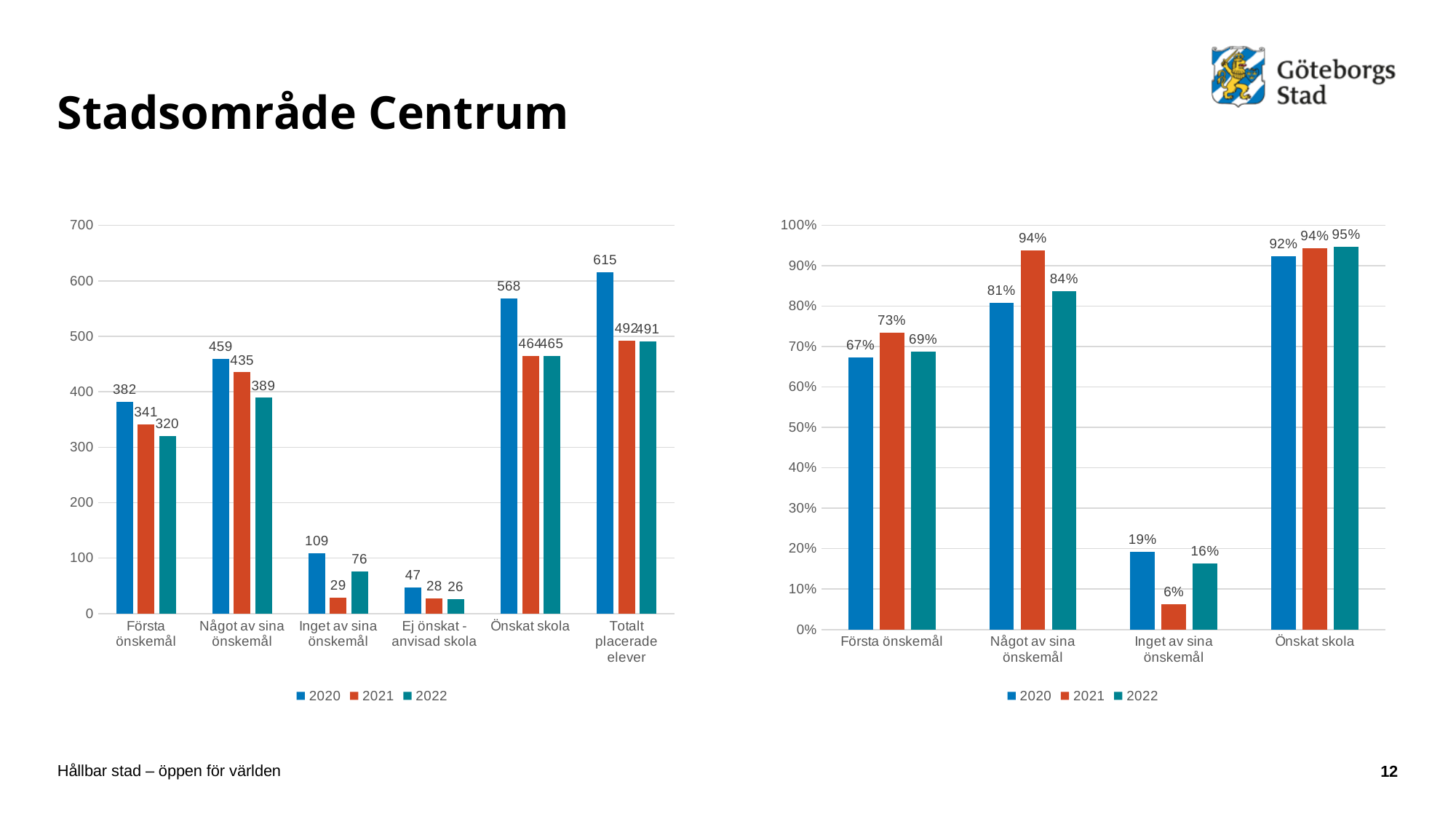
In the right chart, what is the value for 2021 in the category 'Något av sina önskemål'? 94% In the left chart, do the values for 'Något av sina önskemål' rise or fall from 2020 to 2022? fall What type of chart is the left chart? bar chart In the left chart, what is the value for 2020 in the category 'Totalt placerade elever'? 615 How many series does the legend of the right chart list? 3 In the right chart, which year has the lowest value for 'Inget av sina önskemål'? 2021 In the left chart, what is the difference between the 2020 and 2021 values for 'Första önskemål'? 41 In the left chart, what is the value for 2022 in the category 'Inget av sina önskemål'? 76 In the right chart, what is the value for 2022 in the category 'Önskat skola'? 95% In the left chart, which category has the lowest value for 2022? Ej önskat - anvisad skola In the right chart, is the 2020 value for 'Första önskemål' larger or smaller than the 2022 value? smaller In the left chart, how many categories are shown on the x axis? 6